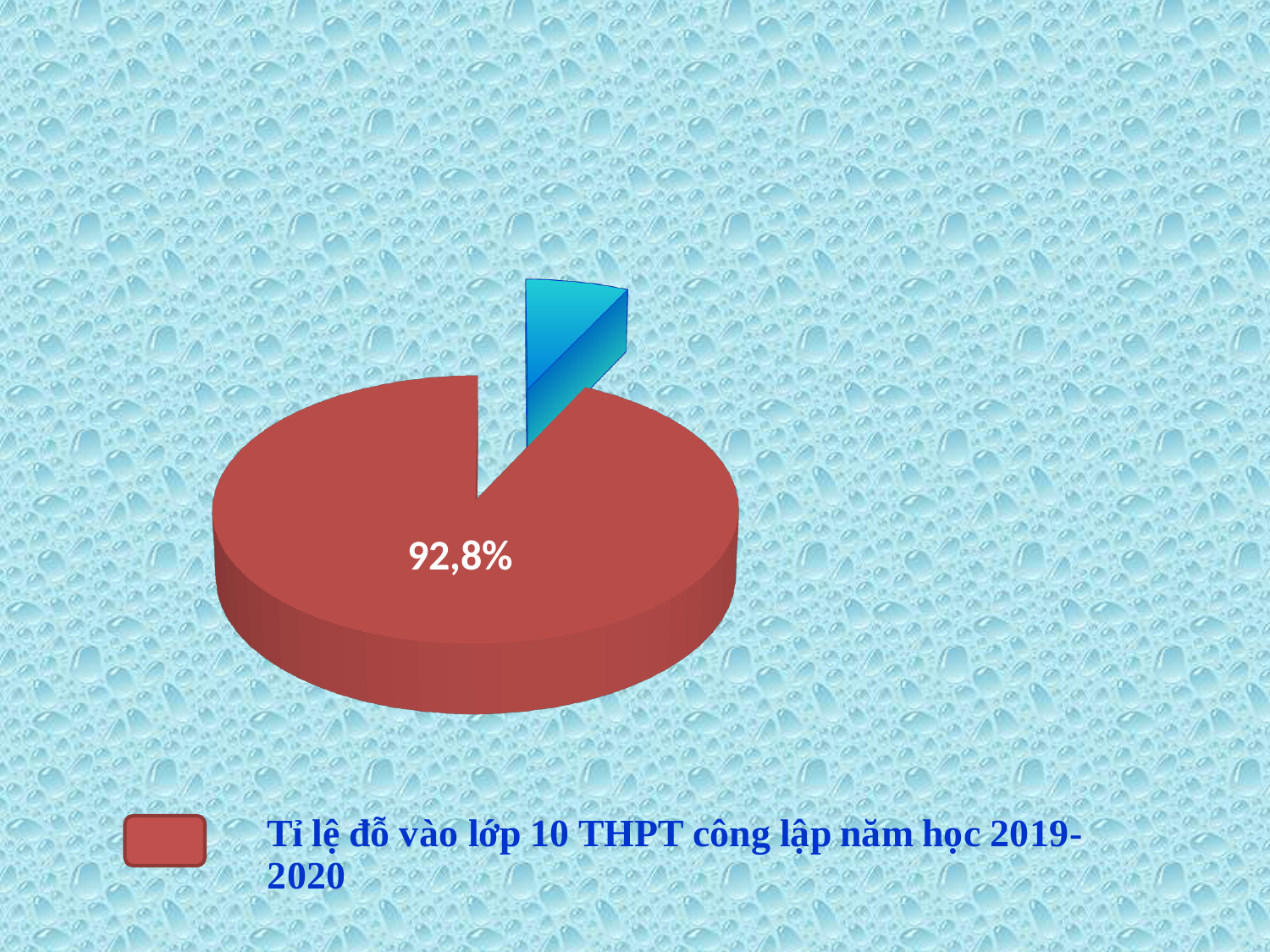
Is the red slice larger or smaller than the blue slice? Larger What label does the legend give for the red slice? Tỉ lệ đỗ vào lớp 10 THPT công lập năm học 2019-2020 What is the value shown for 'Tỉ lệ đỗ vào lớp 10 THPT công lập năm học 2019-2020'? 92,8% How many slices does the pie chart have? 2 How many entries does the legend list? 1 Which slice of the pie chart is the largest? The red slice (92,8%) What percentage is printed on the red slice of the pie chart? 92,8% Which slice of the pie chart is the smallest? The blue slice What share of the pie does the red slice represent? 92,8% What kind of chart is shown on the slide? Pie chart What colour is the slice labelled 92,8%? Red